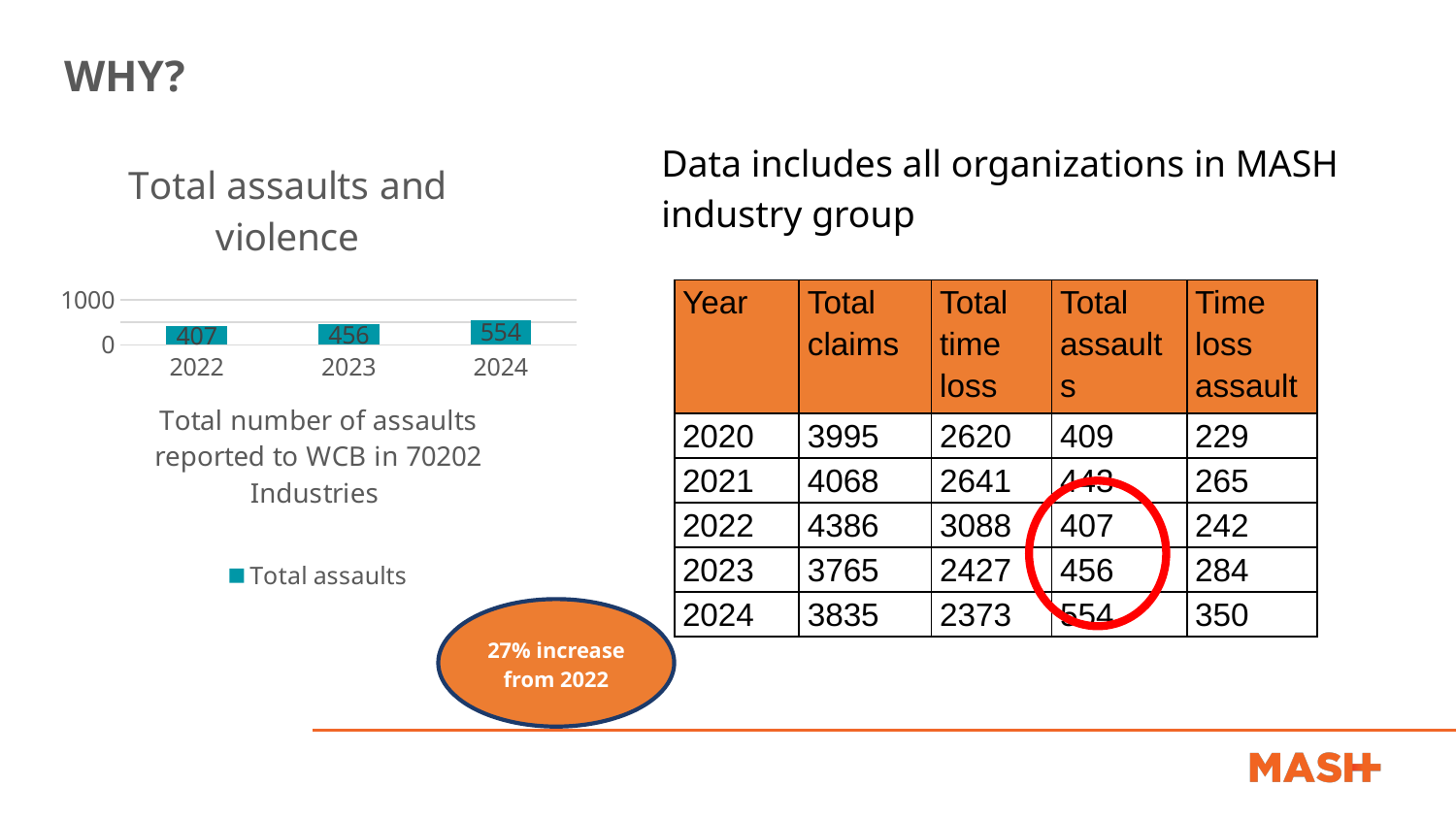
How many series does the legend of the Total assaults and violence chart list? 1 What is the value for 2023 in the Total assaults and violence chart? 456 What is the value for 2022 in the Total assaults and violence chart? 407 Which year has the lowest value in the Total assaults and violence chart? 2022 What is the value for 2024 in the Total assaults and violence chart? 554 Do the values in the Total assaults and violence chart rise or fall from 2022 to 2024? rise What is the difference between the 2023 and 2022 values in the Total assaults and violence chart? 49 How many years are shown on the x axis of the Total assaults and violence chart? 3 What is the difference between the 2024 and 2022 values in the Total assaults and violence chart? 147 In the Total assaults and violence chart, is the value for 2023 larger or smaller than the value for 2024? smaller Which year has the highest value in the Total assaults and violence chart? 2024 What kind of chart is the Total assaults and violence chart? bar chart